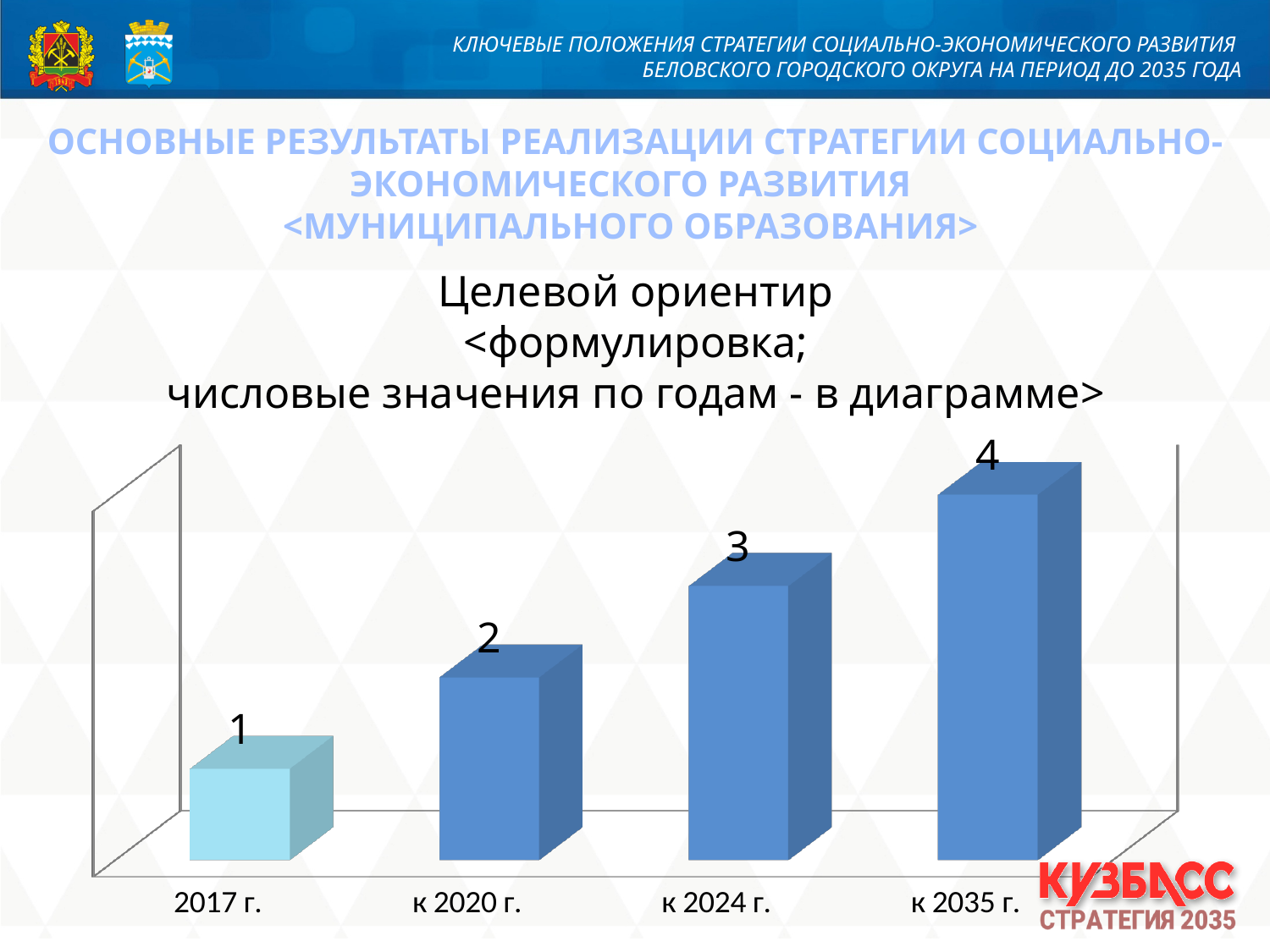
What kind of chart is shown on the slide? bar chart Which category has the highest value? к 2035 г. What is the value shown for к 2024 г.? 3 Which category has the lowest value? 2017 г. How many categories are shown on the x axis of the chart? 4 What is the difference between the values for к 2035 г. and 2017 г.? 3 Do the values rise or fall from 2017 г. to к 2035 г.? rise Which is larger, the value for к 2020 г. or the value for к 2024 г.? к 2024 г. What is the value shown for 2017 г.? 1 What is the value shown for к 2035 г.? 4 What is the value shown for к 2020 г.? 2 What is the difference between the values for к 2024 г. and к 2020 г.? 1